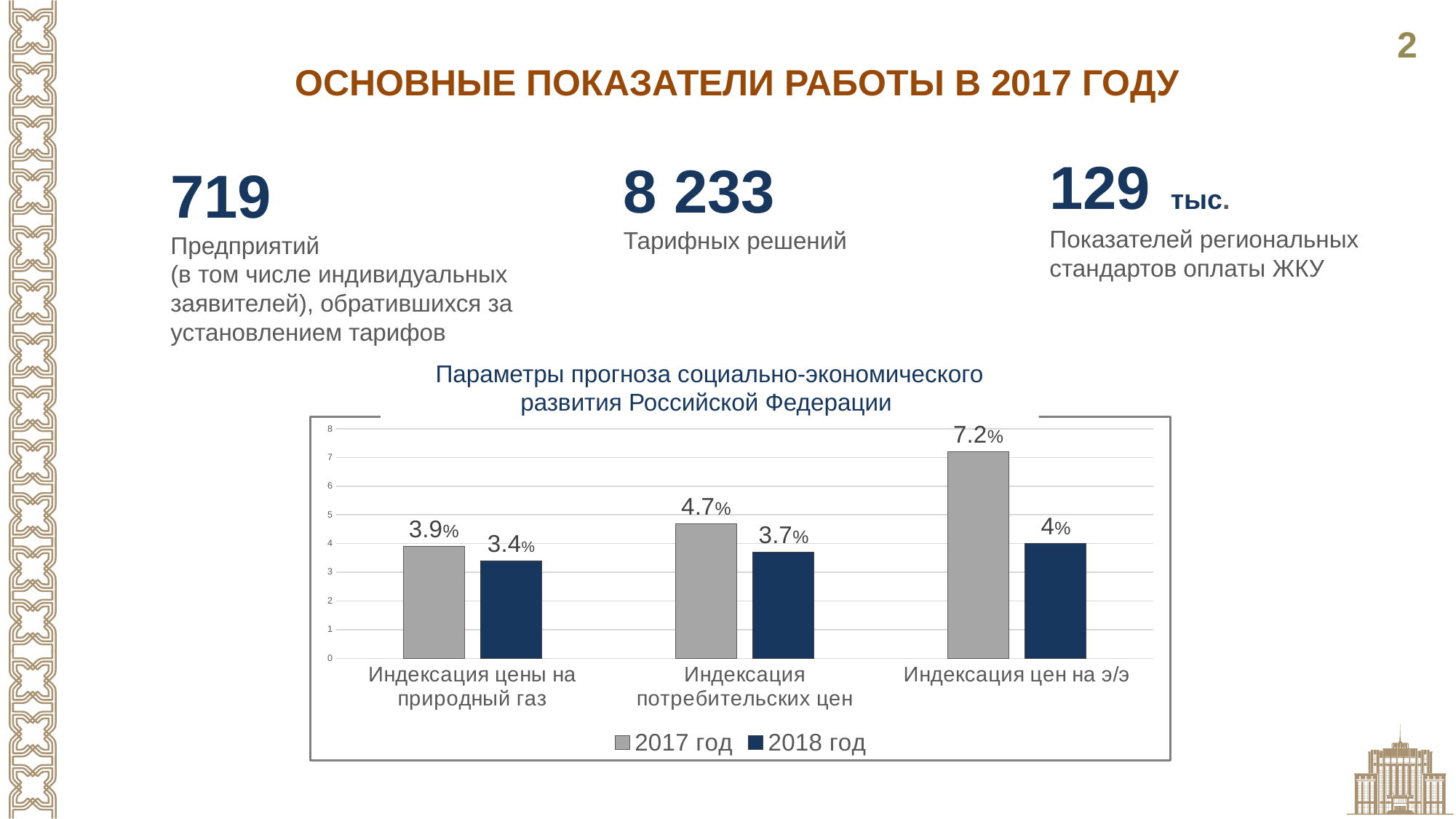
How many categories are shown on the x axis of the chart? 3 What is the value for 2018 год for Индексация потребительских цен? 3.7% Which category has the highest value for 2017 год? Индексация цен на э/э What is the title of the chart? Параметры прогноза социально-экономического развития Российской Федерации What is the difference between the 2017 год and 2018 год values for Индексация цен на э/э? 3.2% What is the value for 2017 год for Индексация цены на природный газ? 3.9% How many series does the chart legend list? 2 Which category has the lowest value for 2018 год? Индексация цены на природный газ What is the value for 2018 год for Индексация цен на э/э? 4% Which is larger for Индексация потребительских цен: the 2017 год value or the 2018 год value? 2017 год What is the value for 2017 год for Индексация цен на э/э? 7.2% What kind of chart is shown on the slide? Bar chart